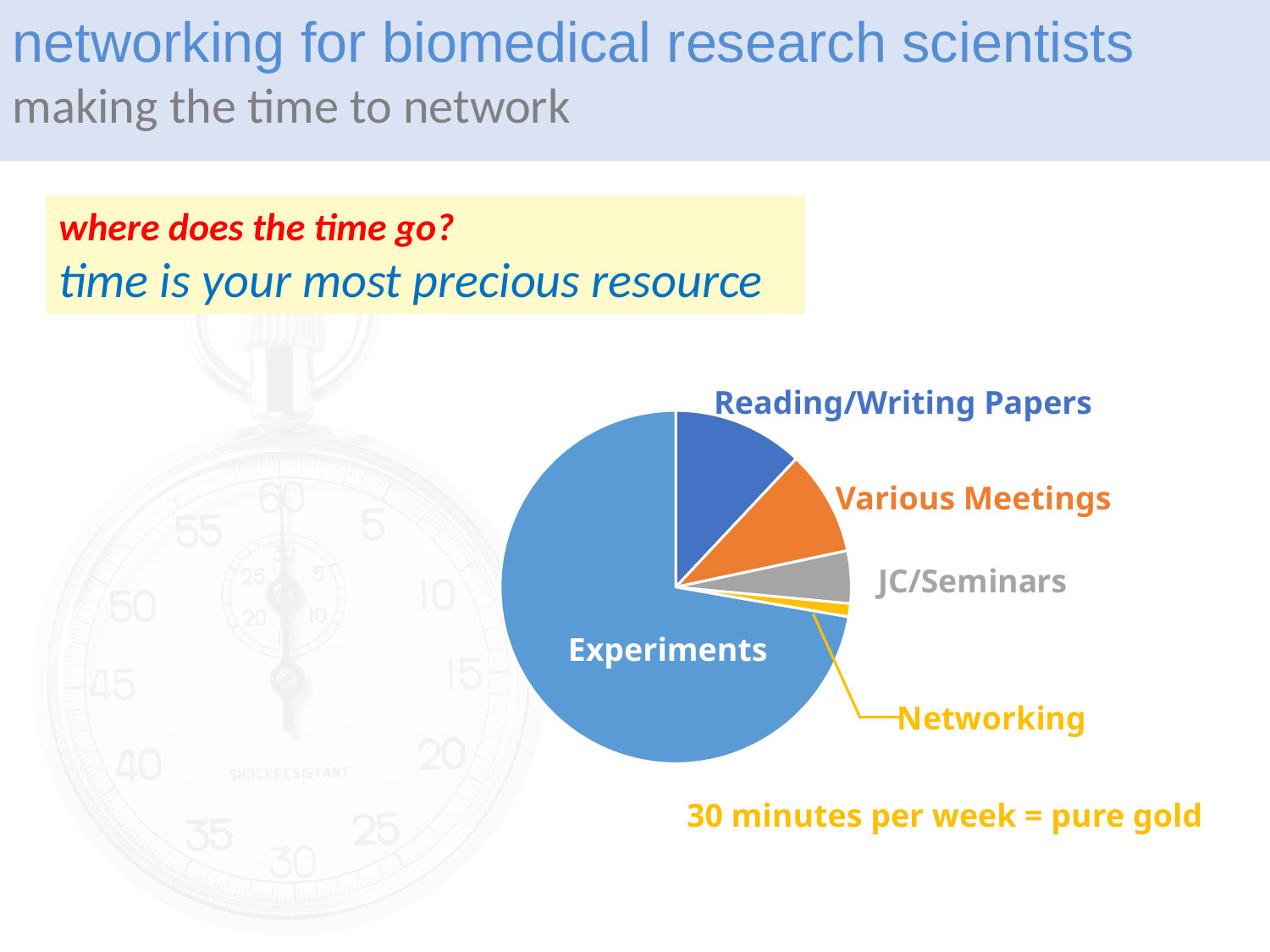
Which slice is larger, Experiments or Various Meetings? Experiments Which category takes up the largest share of the pie chart? Experiments Which slice is larger, JC/Seminars or Networking? JC/Seminars Which slice is larger, Various Meetings or Networking? Various Meetings Which category takes up the smallest share of the pie chart? Networking How many slices does the pie chart have? 5 What colour is the Various Meetings slice of the pie chart? orange What colour is the Networking slice of the pie chart? yellow What kind of chart is shown on the slide? pie chart